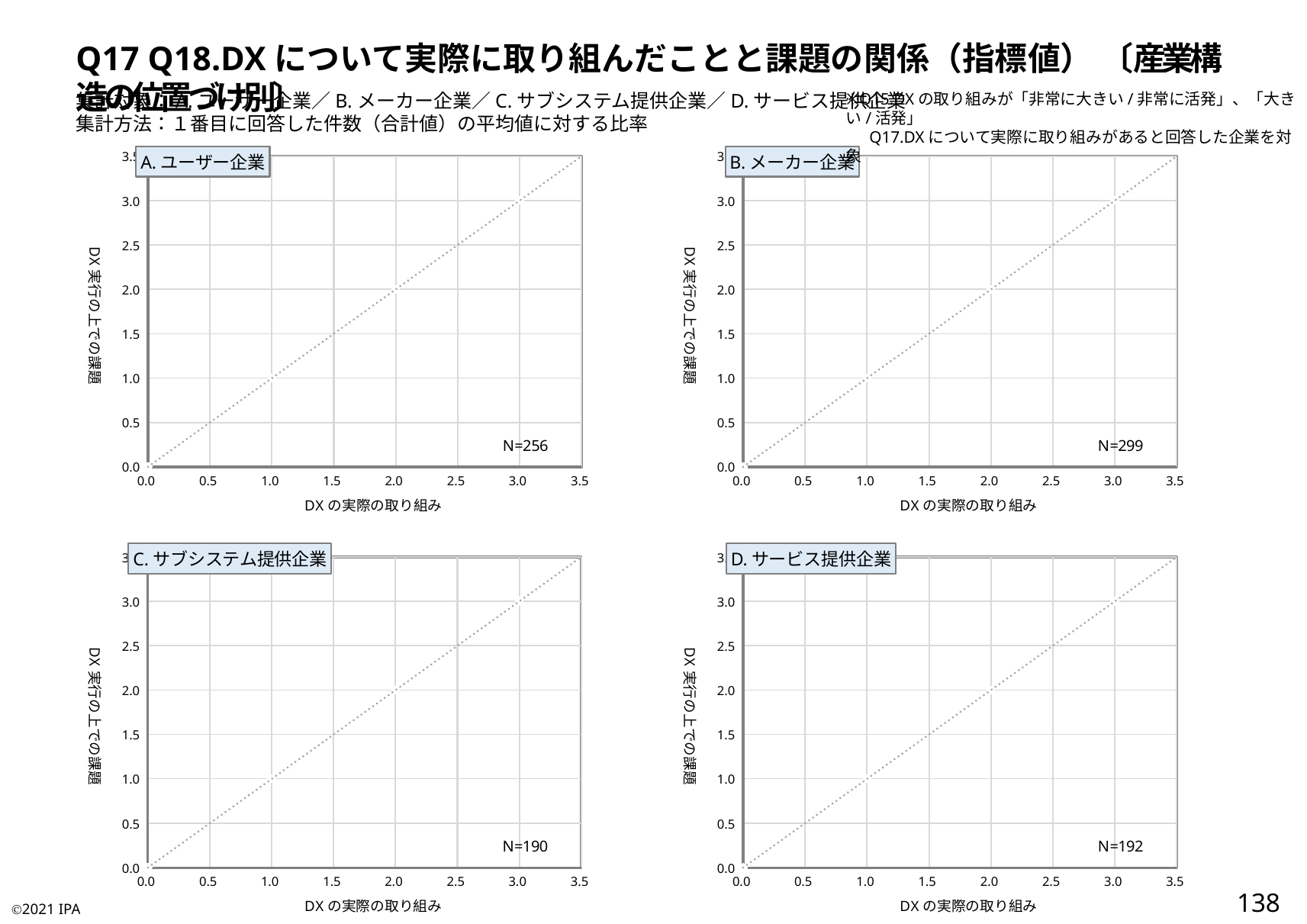
In the chart titled "A. ユーザー企業", what is the N value shown? N=256 What is the difference between the N values of the chart titled "B. メーカー企業" and the chart titled "A. ユーザー企業"? 43 In the chart titled "B. メーカー企業", what is the N value shown? N=299 In the chart titled "A. ユーザー企業", what is the label of the x axis? DX の実際の取り組み In the chart titled "C. サブシステム提供企業", what is the N value shown? N=190 How many charts are shown on the slide? 4 What kind of chart is the chart titled "A. ユーザー企業"? scatter chart Which of the four charts has the largest N value? B. メーカー企業 In the chart titled "D. サービス提供企業", what is the maximum value shown on the y axis? 3.5 In the chart titled "D. サービス提供企業", what is the N value shown? N=192 Which of the four charts has the smallest N value? C. サブシステム提供企業